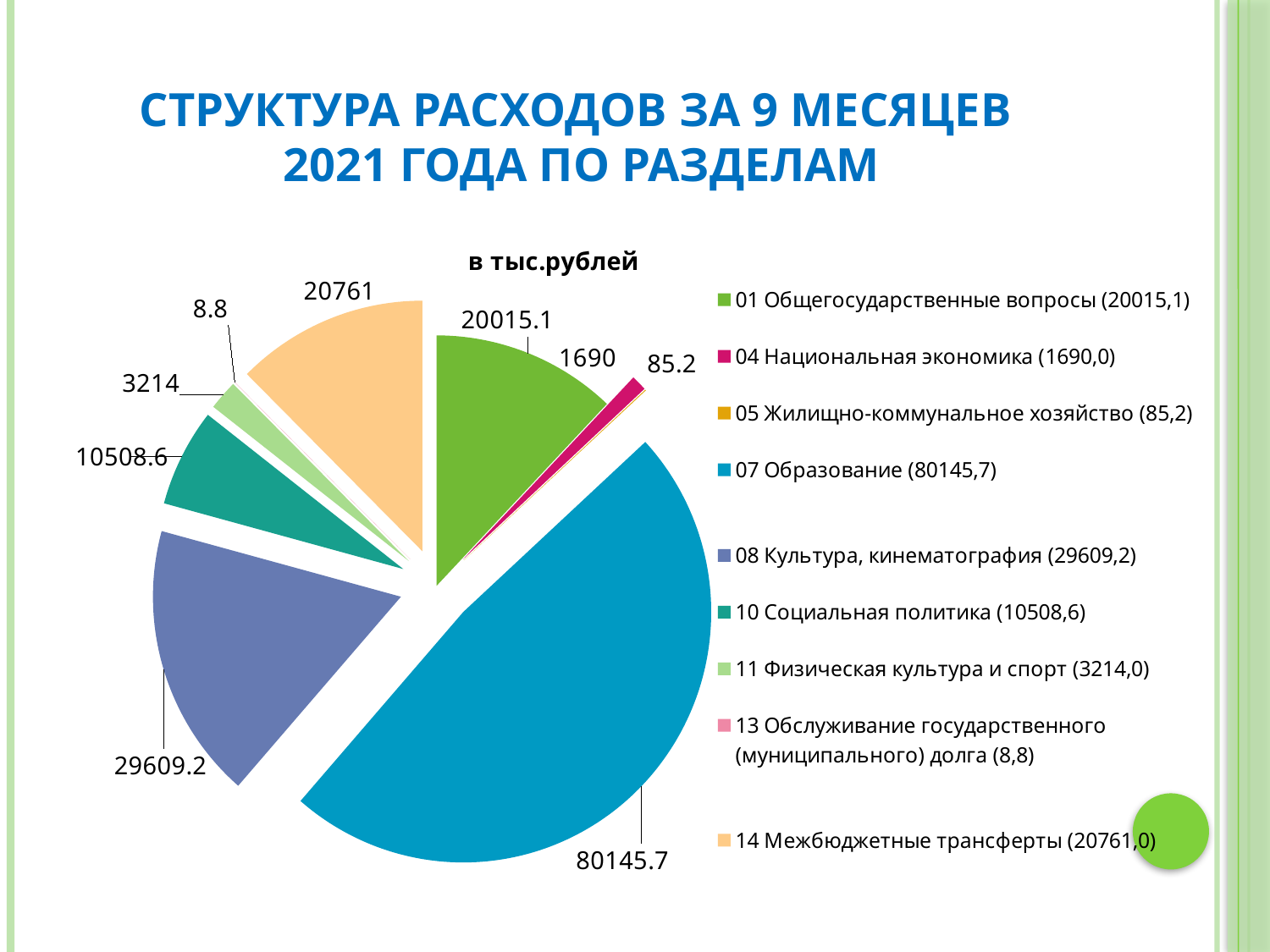
Which is larger: the value for 10 Социальная политика or the value for 11 Физическая культура и спорт? 10 Социальная политика What is the value for 10 Социальная политика on the pie chart? 10508.6 Which section has the largest slice of the pie chart? 07 Образование What is the difference between the values for 14 Межбюджетные трансферты and 01 Общегосударственные вопросы? 745.9 What unit is stated in the chart title above the pie? в тыс.рублей What is the value for 13 Обслуживание государственного (муниципального) долга on the pie chart? 8.8 What type of chart is shown on the slide? Pie chart What is the value for 07 Образование on the pie chart? 80145.7 What is the difference between the values for 07 Образование and 08 Культура, кинематография? 50536.5 Which section has the smallest slice of the pie chart? 13 Обслуживание государственного (муниципального) долга What is the value for 08 Культура, кинематография on the pie chart? 29609.2 How many slices does the pie chart have? 9